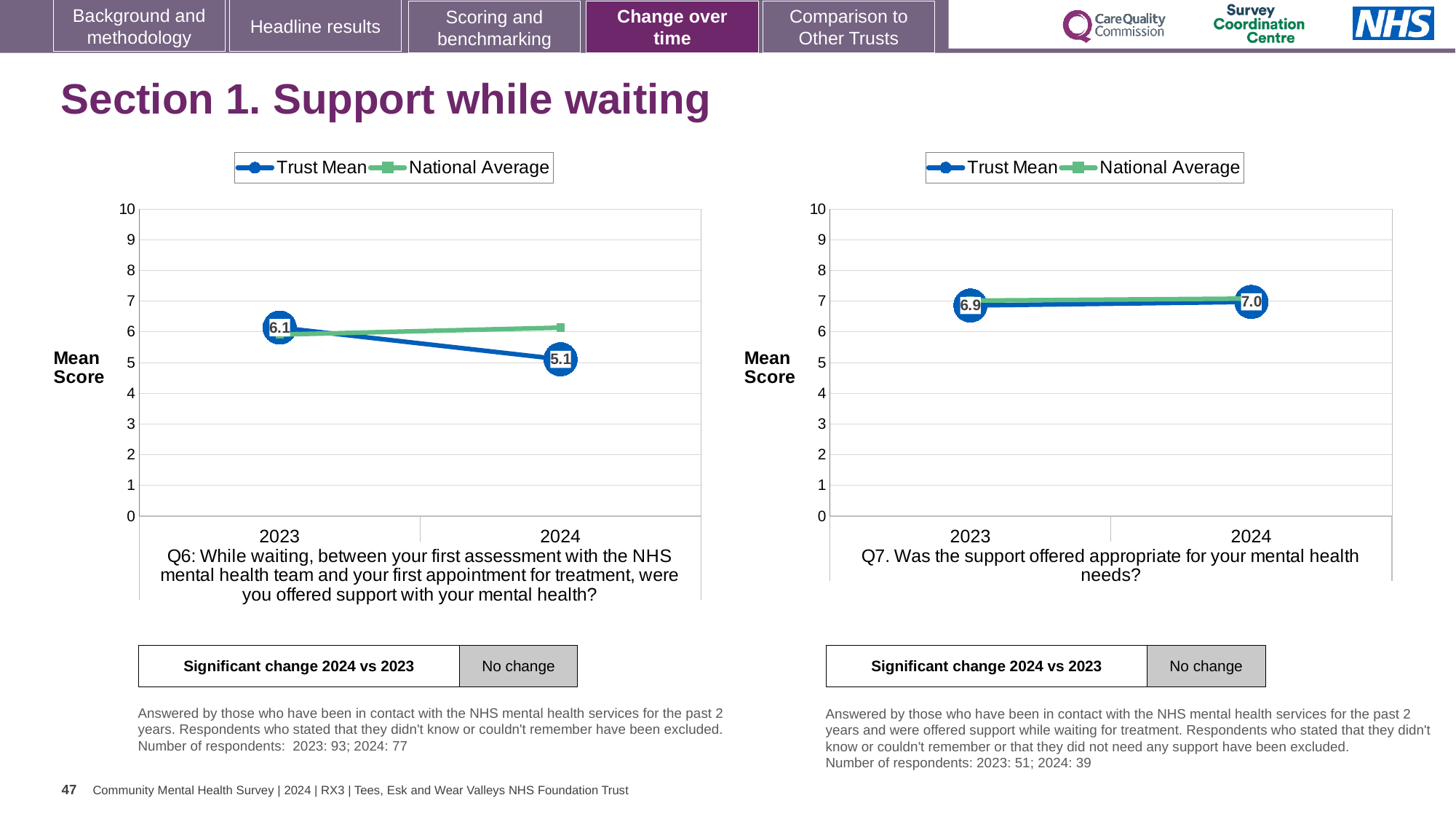
On the left chart (Q6), in 2024 which is larger, the Trust Mean or the National Average? National Average On the right chart (Q7), is the National Average for 2023 greater or less than 5? greater On the right chart (Q7), what is the Trust Mean score for 2024? 7.0 On the left chart (Q6), what is the Trust Mean score for 2023? 6.1 On the left chart (Q6), does the Trust Mean rise or fall from 2023 to 2024? fall On the left chart (Q6), what is the Trust Mean score for 2024? 5.1 On the left chart (Q6), by how much did the Trust Mean fall from 2023 to 2024? 1.0 How many series does the legend of the right chart (Q7) list? 2 On the right chart (Q7), what is the Trust Mean score for 2023? 6.9 On the right chart (Q7), in which year is the Trust Mean higher? 2024 On the left chart (Q6), is the National Average for 2024 greater or less than 5? greater What kind of chart is the left chart (Q6)? line chart